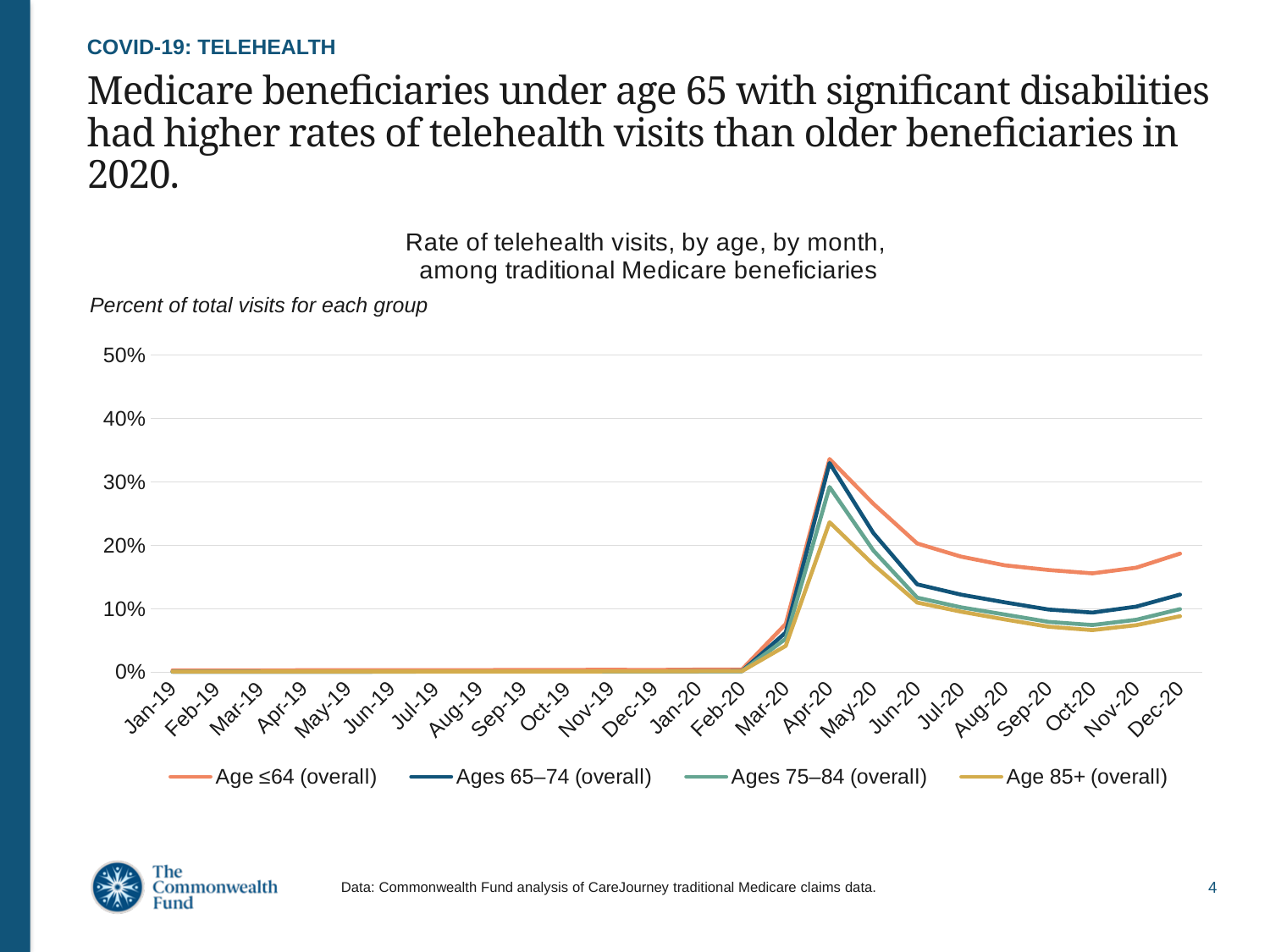
Which age group has the lowest rate of telehealth visits in Apr-20? Age 85+ (overall) How many months are plotted along the x axis? 24 Which is larger in Dec-20, the value for Age ≤64 (overall) or the value for Ages 75–84 (overall)? Age ≤64 (overall) Is the value for Ages 65–74 (overall) in Dec-20 greater or less than 10%? greater What kind of chart is shown on the slide? line chart Do the values for Age ≤64 (overall) rise or fall from Apr-20 to Oct-20? fall Is the value for Age 85+ (overall) in Apr-20 greater or less than 30%? less Which age group has the highest rate of telehealth visits in Apr-20? Age ≤64 (overall) Is the value for Age ≤64 (overall) in Apr-20 greater or less than 30%? greater How many series does the legend list? 4 What is the unit described on the y axis label of the chart? Percent of total visits for each group In which month does the Age ≤64 (overall) line reach its highest value? Apr-20